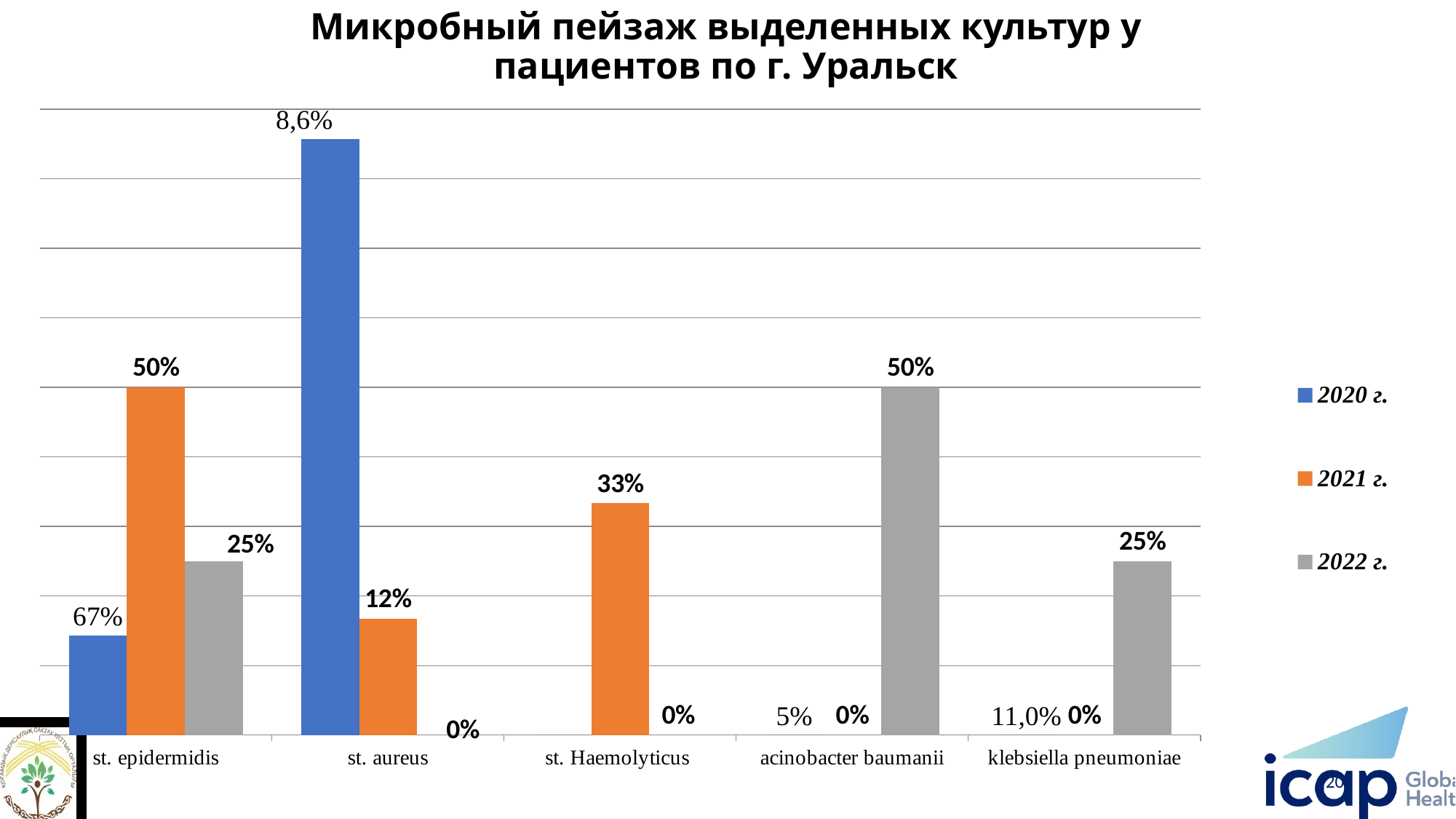
What is the value for st. epidermidis in the 2021 г. series? 50% How many series does the legend list? 3 What is the value for st. aureus in the 2021 г. series? 12% What is the difference between the 2021 г. values for st. epidermidis and st. Haemolyticus? 17% Which category has the highest value in the 2022 г. series? acinobacter baumanii What is the value for klebsiella pneumoniae in the 2022 г. series? 25% Which category has the highest value in the 2021 г. series? st. epidermidis Which series is shown in orange in the legend? 2021 г. How many categories are shown on the x axis? 5 What is the value for st. Haemolyticus in the 2021 г. series? 33% What type of chart is shown on the slide? bar chart What is the value for acinobacter baumanii in the 2022 г. series? 50%